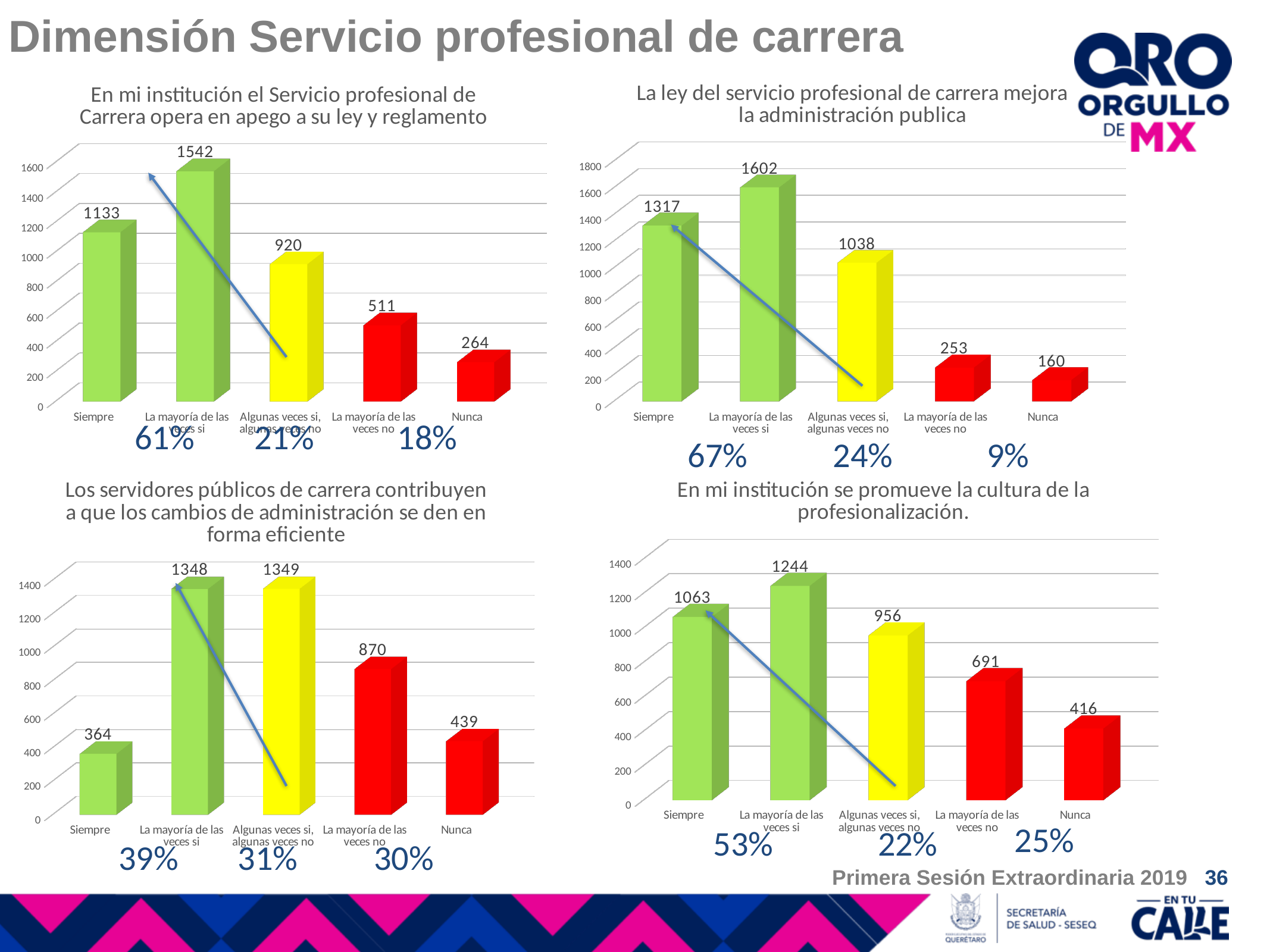
How many categories are shown in the top-left chart? 5 In the bottom-right chart, what is the value for 'Algunas veces si, algunas veces no'? 956 In the bottom-right chart, which is larger: 'La mayoría de las veces no' or 'Nunca'? La mayoría de las veces no In the top-right chart, which category has the lowest value? Nunca In the bottom-left chart, what is the value for 'La mayoría de las veces no'? 870 In the top-left chart, what is the value for 'Siempre'? 1133 In the top-right chart, what is the value for 'Nunca'? 160 In the bottom-left chart, which category has the lowest value? Siempre What type of chart is the top-right chart? Bar chart In the bottom-right chart, what is the difference between 'La mayoría de las veces si' and 'Siempre'? 181 In the top-right chart, what is the difference between 'La mayoría de las veces si' and 'Siempre'? 285 In the top-left chart, which category has the highest value? La mayoría de las veces si